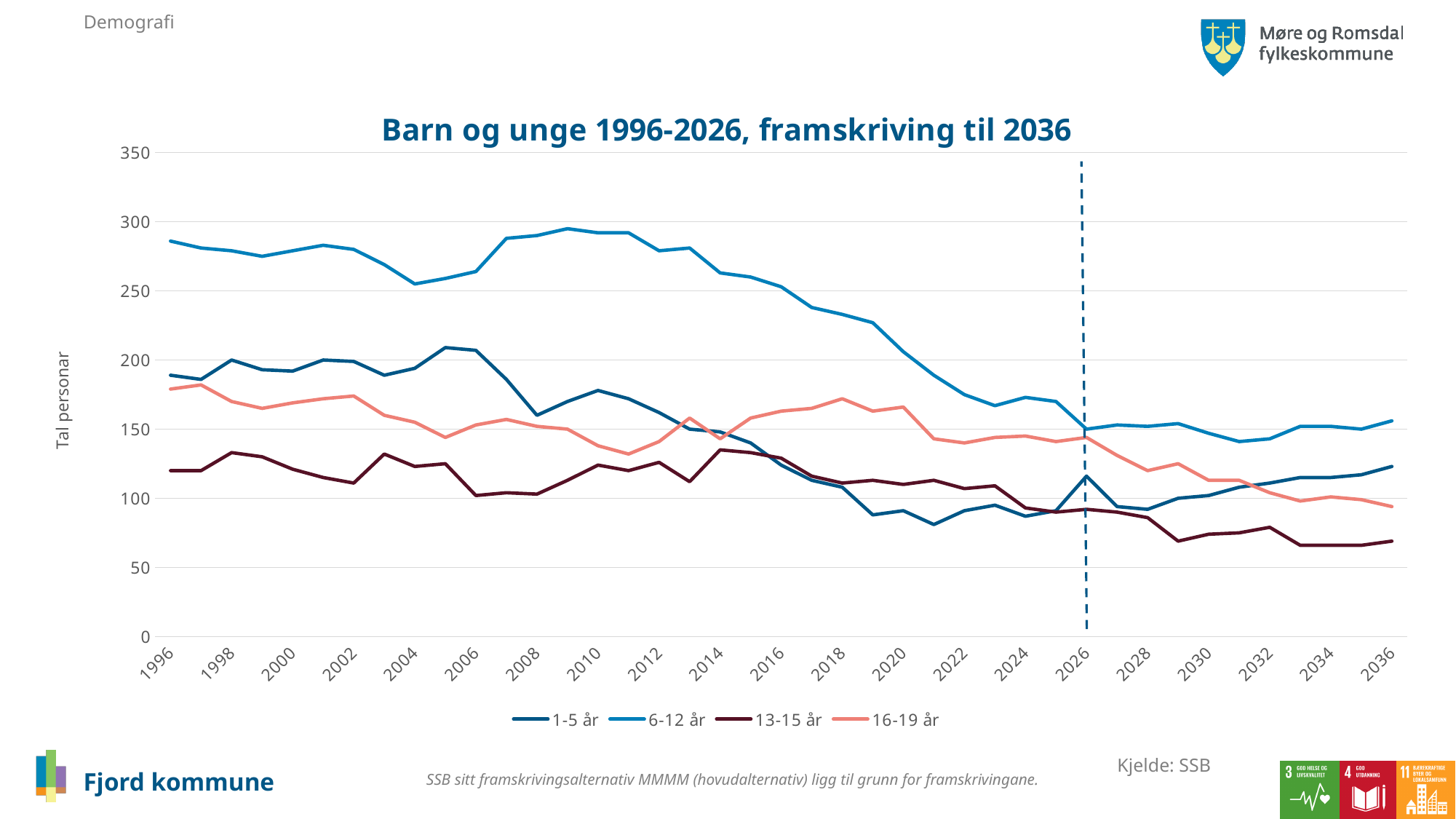
In 2020, which is larger: the value for 16-19 år or the value for 13-15 år? 16-19 år Which series has the lowest value in 2036? 13-15 år Is the value for 1-5 år in 2022 greater or less than 100? less How many year labels are shown on the x axis? 21 Is the value for 6-12 år in 1996 greater or less than 250? greater How many series does the legend list? 4 What is the title of the chart? Barn og unge 1996-2026, framskriving til 2036 Which series has the highest value in 2010? 6-12 år Does the 6-12 år series rise or fall between 2010 and 2026? fall Is the value for 13-15 år in 2036 greater or less than 100? less What type of chart is shown on the slide? line chart Which age groups are listed in the legend? 1-5 år, 6-12 år, 13-15 år, 16-19 år